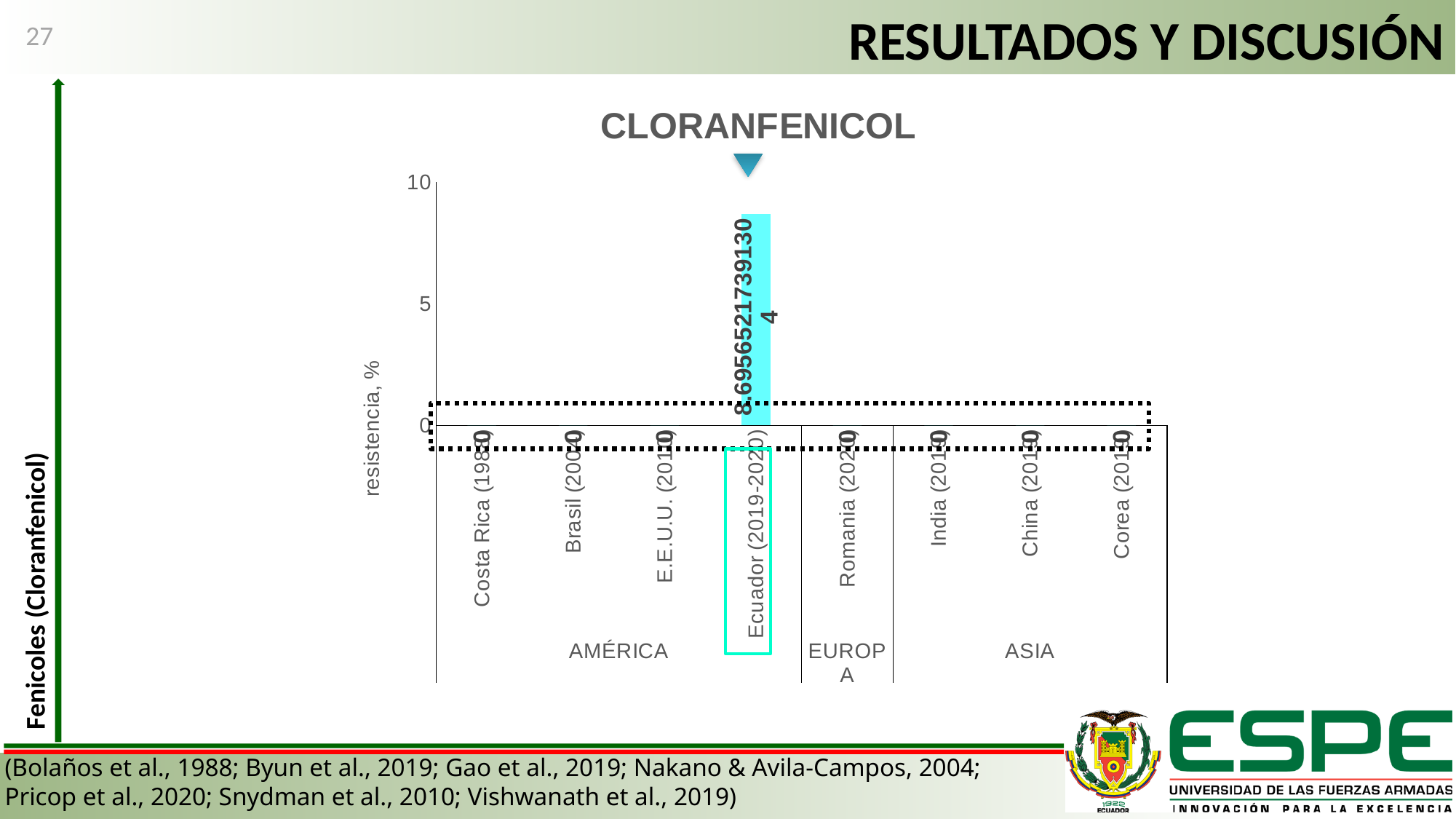
Is the resistance value for Ecuador (2019-2020) greater or less than 10? less What type of chart is shown on the slide? bar chart Which is larger, the resistance value for Ecuador (2019-2020) or for India (2019)? Ecuador (2019-2020) What is the resistance value shown for China (2019)? 0 Which country has the highest resistance value in the chart? Ecuador (2019-2020) What is the resistance value shown for Romania (2020)? 0 What is the label of the vertical axis? resistencia, % What is the resistance value shown for Brasil (2004)? 0 How many countries (categories) are plotted in the chart? 8 How many countries in the chart have a resistance value of 0? 7 What is the title of the chart? CLORANFENICOL Is the resistance value for Ecuador (2019-2020) greater or less than 5? greater